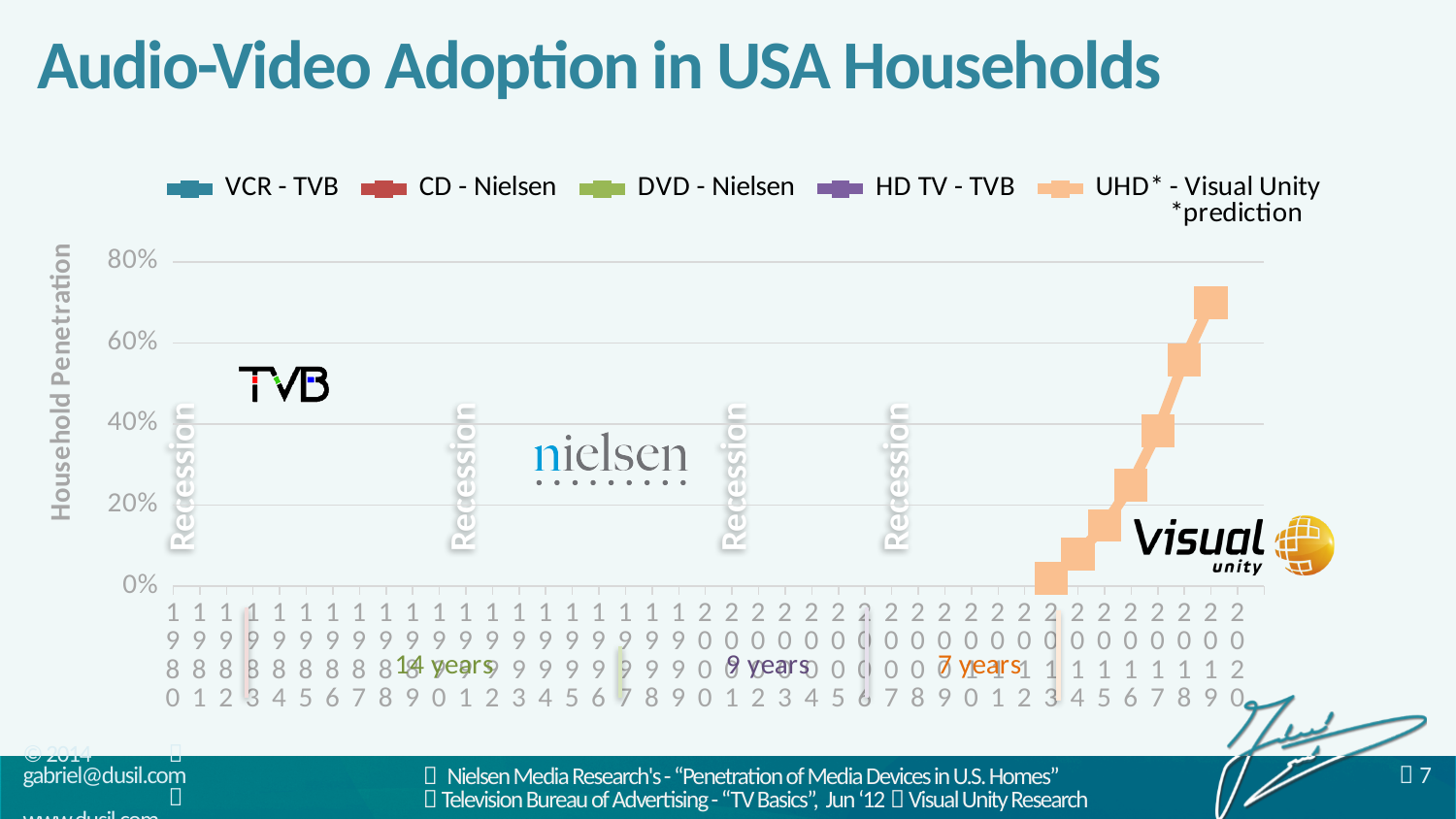
Is the UHD - Visual Unity value for 2014 greater or less than 20%? less Which year has the larger UHD - Visual Unity value, 2015 or 2018? 2018 How many data points are plotted for the UHD - Visual Unity series? 7 In which year is the plotted UHD - Visual Unity value highest? 2019 What is the label on the vertical axis of the chart? Household Penetration Is the UHD - Visual Unity value for 2013 greater or less than 20%? less Is the UHD - Visual Unity value for 2019 greater or less than 60%? greater In which year is the plotted UHD - Visual Unity value lowest? 2013 How many series does the chart legend list? 5 Do the plotted UHD - Visual Unity values rise or fall from 2013 to 2019? rise What is the title of the slide containing the chart? Audio-Video Adoption in USA Households